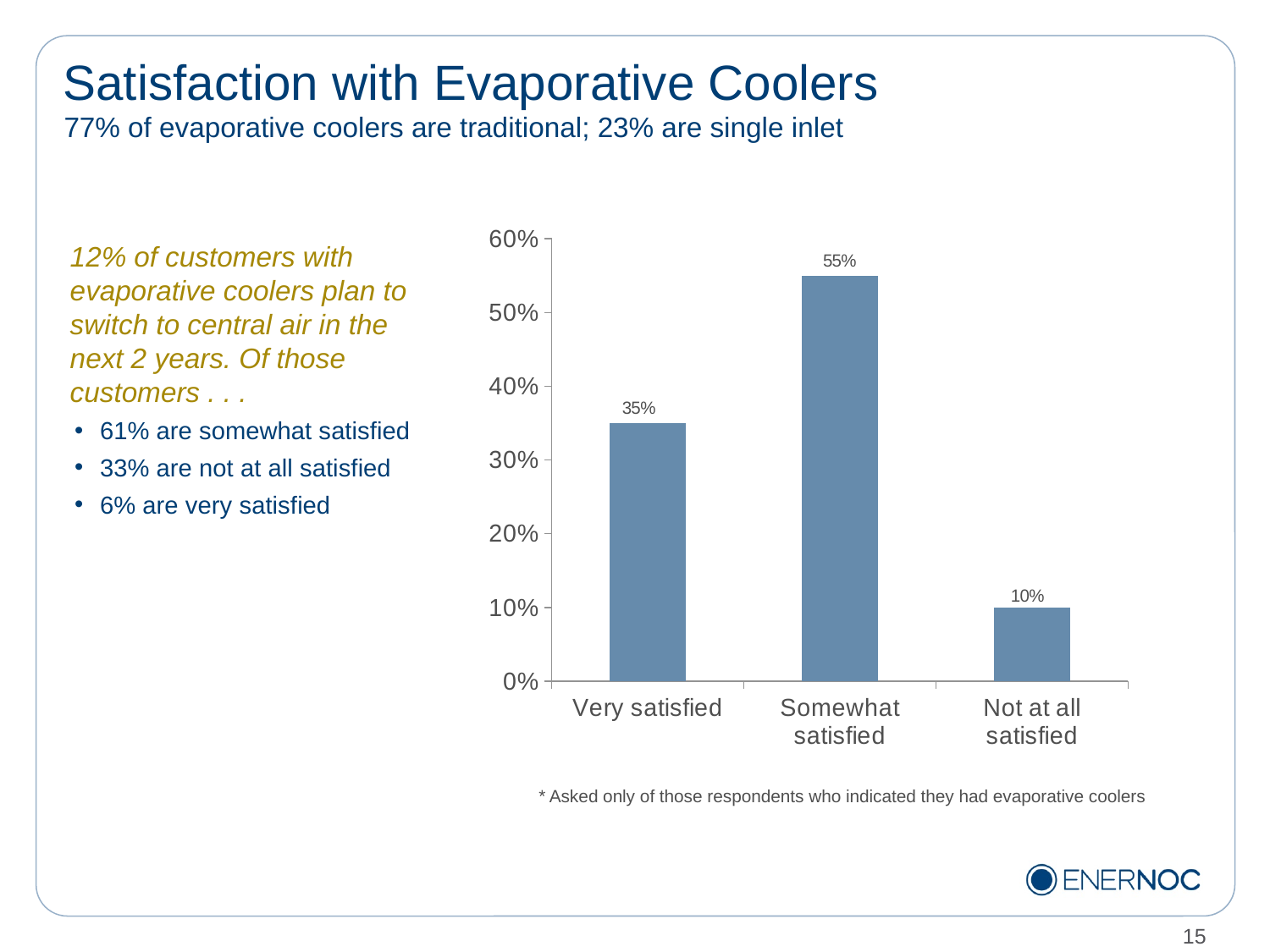
Which satisfaction category has the highest percentage? Somewhat satisfied What percentage of respondents are not at all satisfied with their evaporative coolers? 10% What is the maximum value shown on the chart's vertical axis? 60% What type of chart is used to show satisfaction with evaporative coolers? Bar chart Which satisfaction category has the lowest percentage? Not at all satisfied What percentage of respondents are very satisfied with their evaporative coolers? 35% How many satisfaction categories are shown in the chart? 3 What percentage of respondents are somewhat satisfied with their evaporative coolers? 55% What is the difference in percentage points between the somewhat satisfied and very satisfied categories? 20 percentage points Is the value for somewhat satisfied greater or less than 50%? greater Which is larger, the percentage for very satisfied or for not at all satisfied? Very satisfied What is the difference in percentage points between the very satisfied and not at all satisfied categories? 25 percentage points